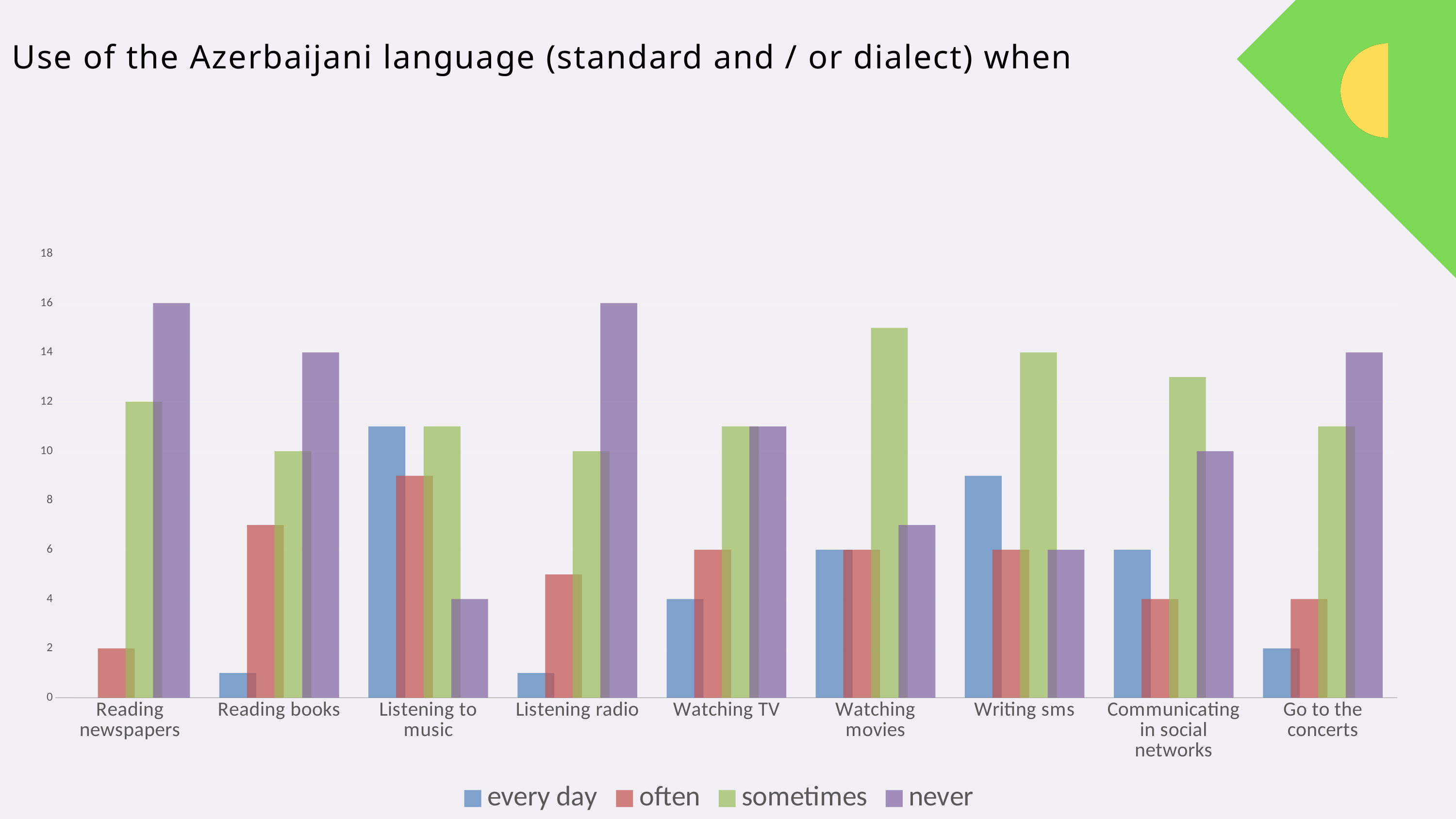
What is the value of the 'never' bar for Reading newspapers? 16 Is the 'every day' value for Listening to music greater or less than 10? greater Is the 'sometimes' value for Watching movies greater or less than 14? greater What is the value of the 'never' bar for Communicating in social networks? 10 Which is larger: the 'never' value for Reading newspapers or the 'never' value for Reading books? Reading newspapers Which category has the lowest 'never' bar? Listening to music What is the value of the 'sometimes' bar for Writing sms? 14 How many activity categories are shown along the x axis? 9 For Reading newspapers, what is the difference between the 'never' value and the 'sometimes' value? 4 How many series does the legend list? 4 What kind of chart is shown on the slide? bar chart Which category has the highest 'every day' bar? Listening to music